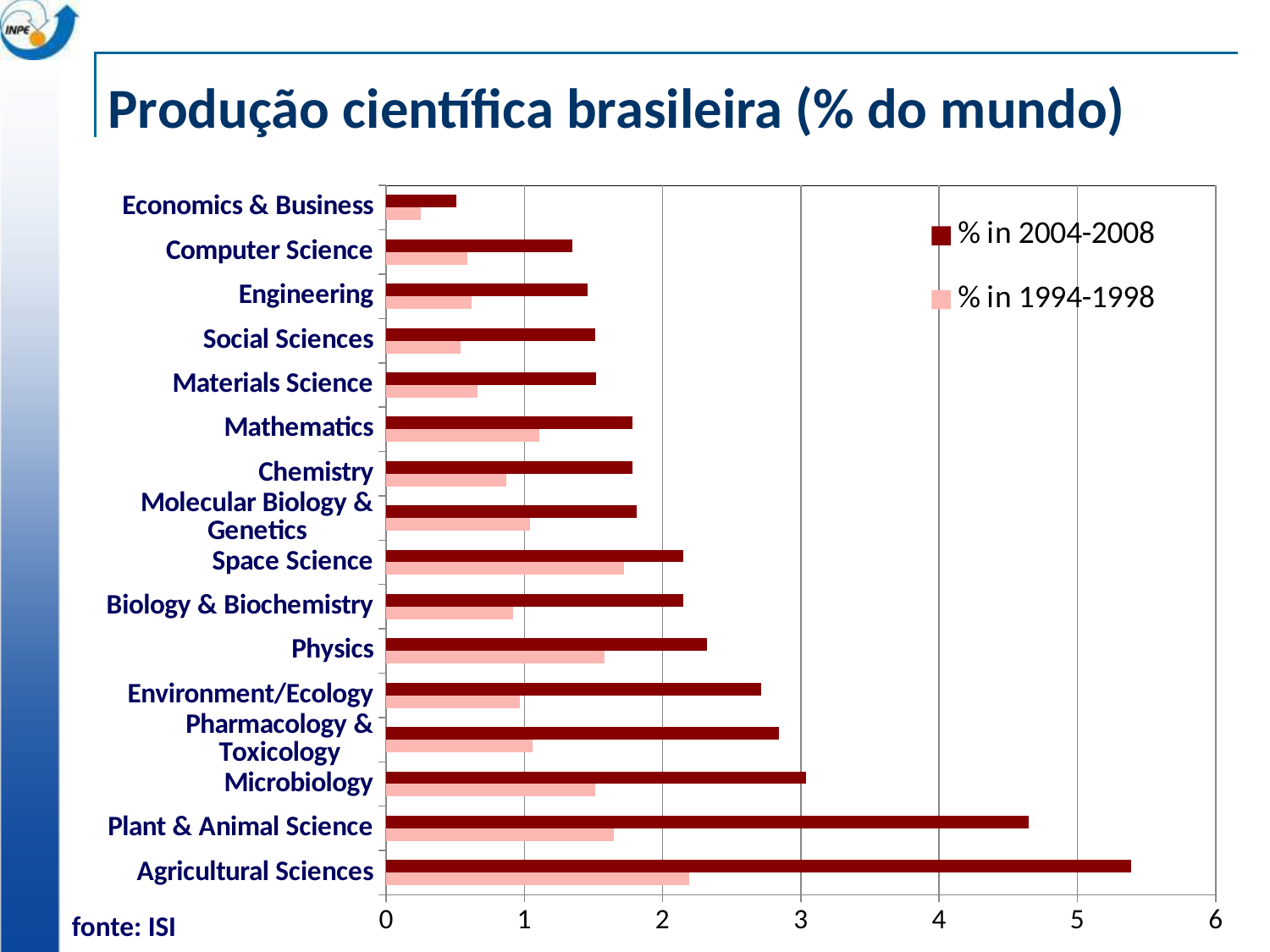
How many categories (fields) are shown on the chart? 16 Is the value for Environment/Ecology in 2004-2008 greater or less than 3? less Which field has the lowest value for % in 2004-2008? Economics & Business Is the value for Agricultural Sciences in 2004-2008 greater or less than 5? greater Is the value for Physics in 2004-2008 greater or less than 2? greater Which field has the highest value for % in 2004-2008? Agricultural Sciences What is the title of the chart on the slide? Produção científica brasileira (% do mundo) What kind of chart is shown on the slide? bar chart Which field has the highest value for % in 1994-1998? Agricultural Sciences How many series does the legend list? 2 Which is larger for % in 2004-2008: Plant & Animal Science or Microbiology? Plant & Animal Science